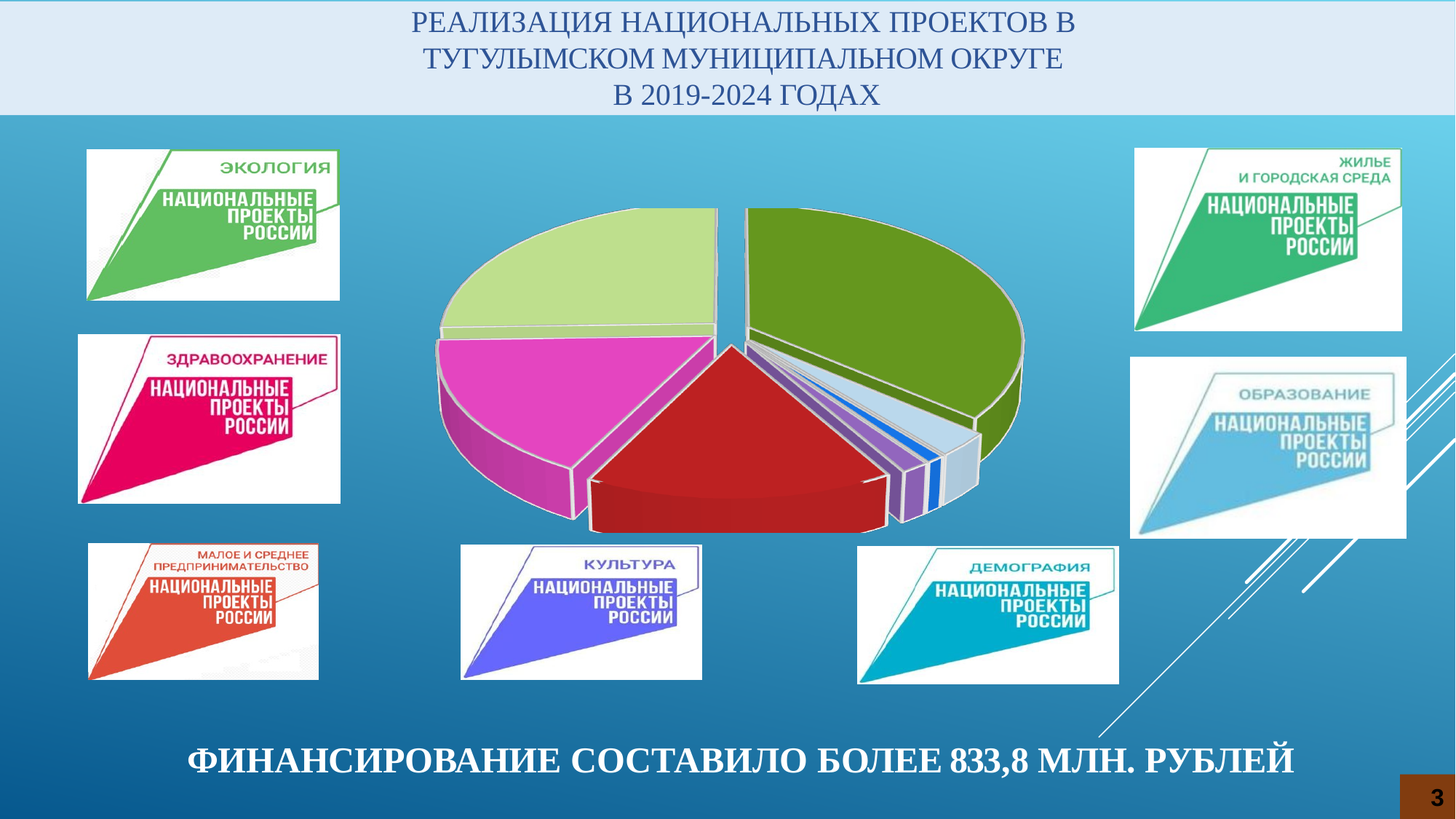
Does the pie chart display a legend? No Does the pie chart show data labels with values on its slices? No How many slices does the pie chart have? 7 Which colour slice of the pie chart is the smallest? blue What kind of chart is shown in the centre of the slide? pie chart